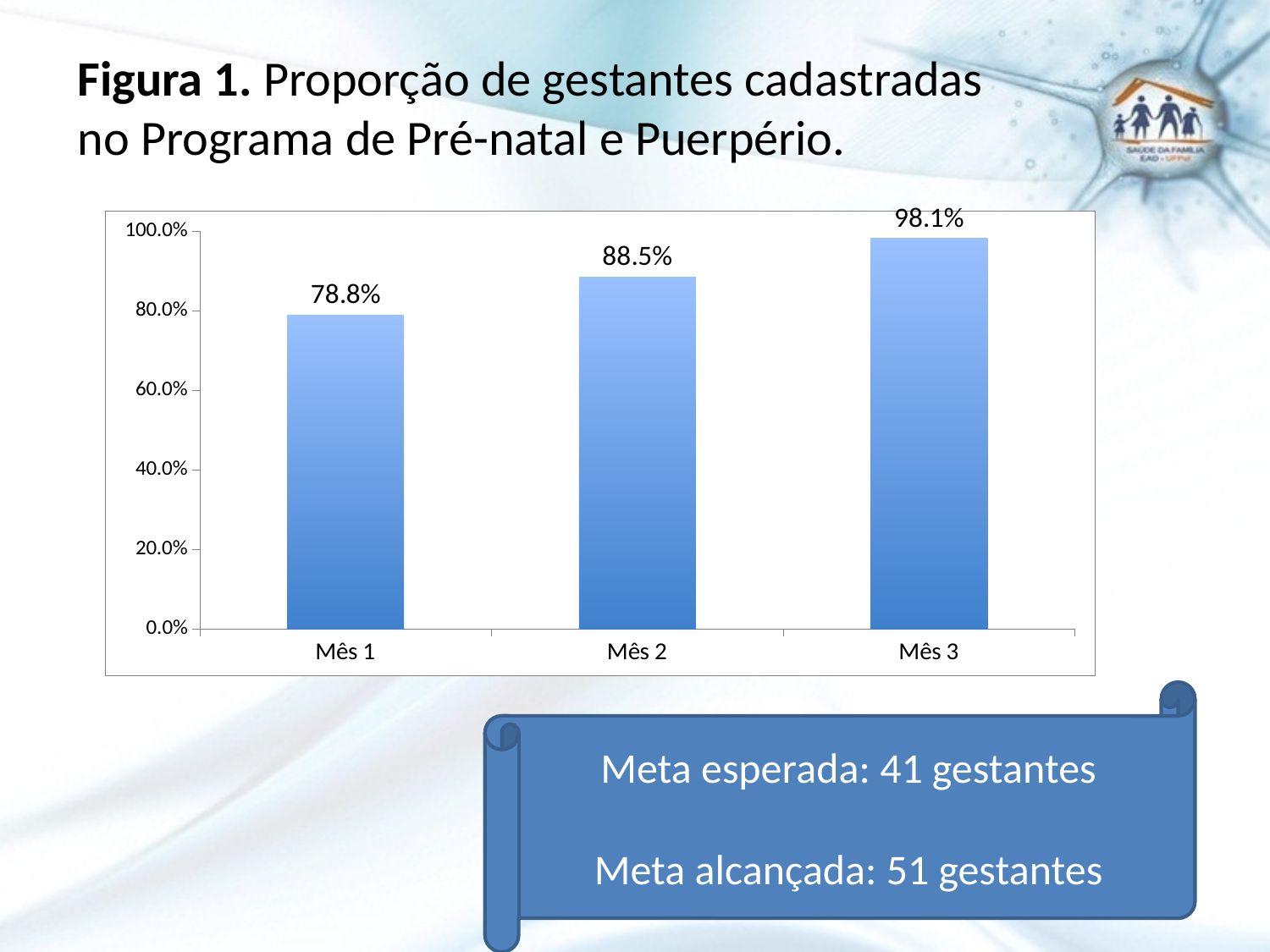
Do the values rise or fall from Mês 1 to Mês 3? rise Which month has the highest value? Mês 3 Which is larger, the value for Mês 2 or the value for Mês 3? Mês 3 What kind of chart is shown on the slide? bar chart Is the value for Mês 1 greater or less than 80.0%? less Which month has the lowest value? Mês 1 What is the difference between the values for Mês 3 and Mês 1? 19.3% What is the value for Mês 2? 88.5% What is the value for Mês 3? 98.1% What is the value for Mês 1? 78.8% How many months are shown on the x axis? 3 What is the difference between the values for Mês 2 and Mês 1? 9.7%